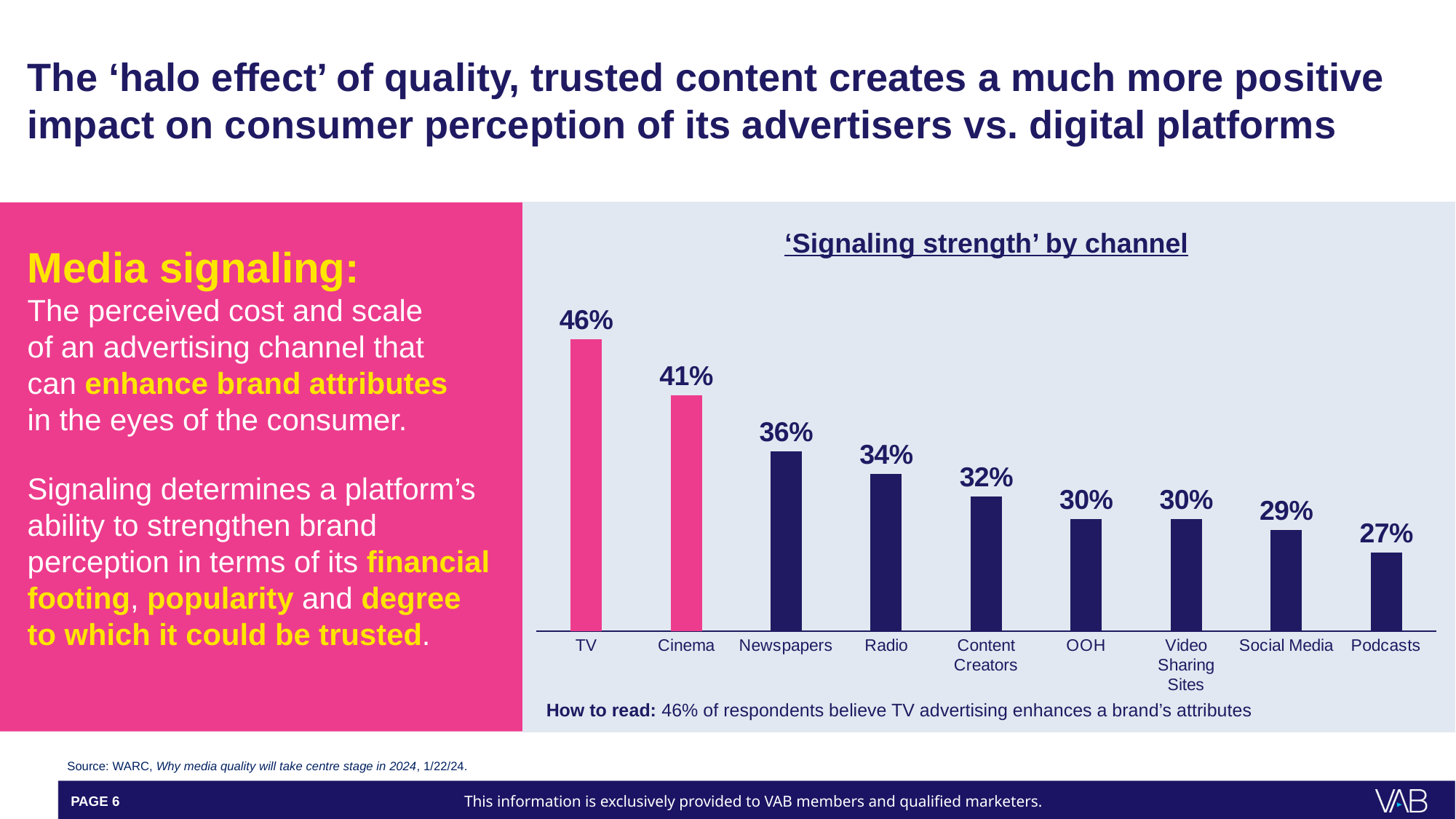
What is the value for Newspapers? 36% What is the value for Podcasts? 27% What is the value for Content Creators? 32% What is the difference between the values for Radio and Social Media? 5% Which channel has the lowest signaling strength? Podcasts What is the value for TV in the 'Signaling strength' by channel chart? 46% What kind of chart is shown on the slide? Bar chart How many channels are shown in the chart? 9 Which two channels are shown with pink bars rather than dark blue bars? TV and Cinema What is the difference between the values for TV and Cinema? 5% Which channel has the highest signaling strength? TV Which is larger, the value for Cinema or the value for Radio? Cinema